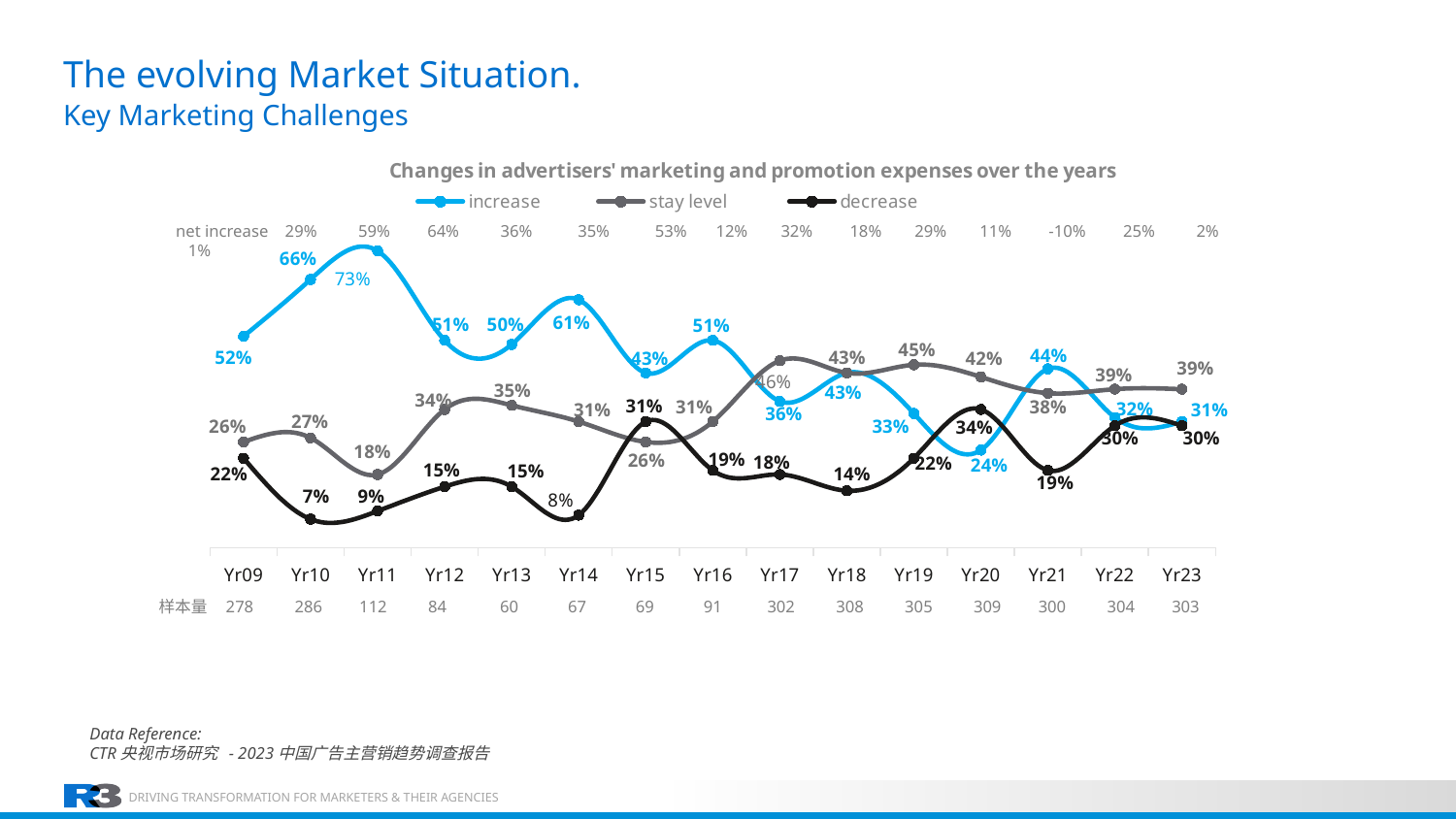
What is the value of the 'increase' series for Yr11? 73% What is the value of the 'stay level' series for Yr17? 46% How many series does the legend list? 3 In which year does the 'decrease' series have its lowest value? Yr10 In which year does the 'increase' series reach its highest value? Yr11 How many years are plotted along the x axis? 15 What is the value of the 'decrease' series for Yr20? 34% What is the title of the chart? Changes in advertisers' marketing and promotion expenses over the years Does the 'increase' series rise or fall from Yr21 to Yr23? fall Which is larger for Yr19: the 'stay level' value or the 'increase' value? stay level What is the difference between the 'increase' value for Yr10 and the 'increase' value for Yr20? 42% What kind of chart is shown on the slide? line chart